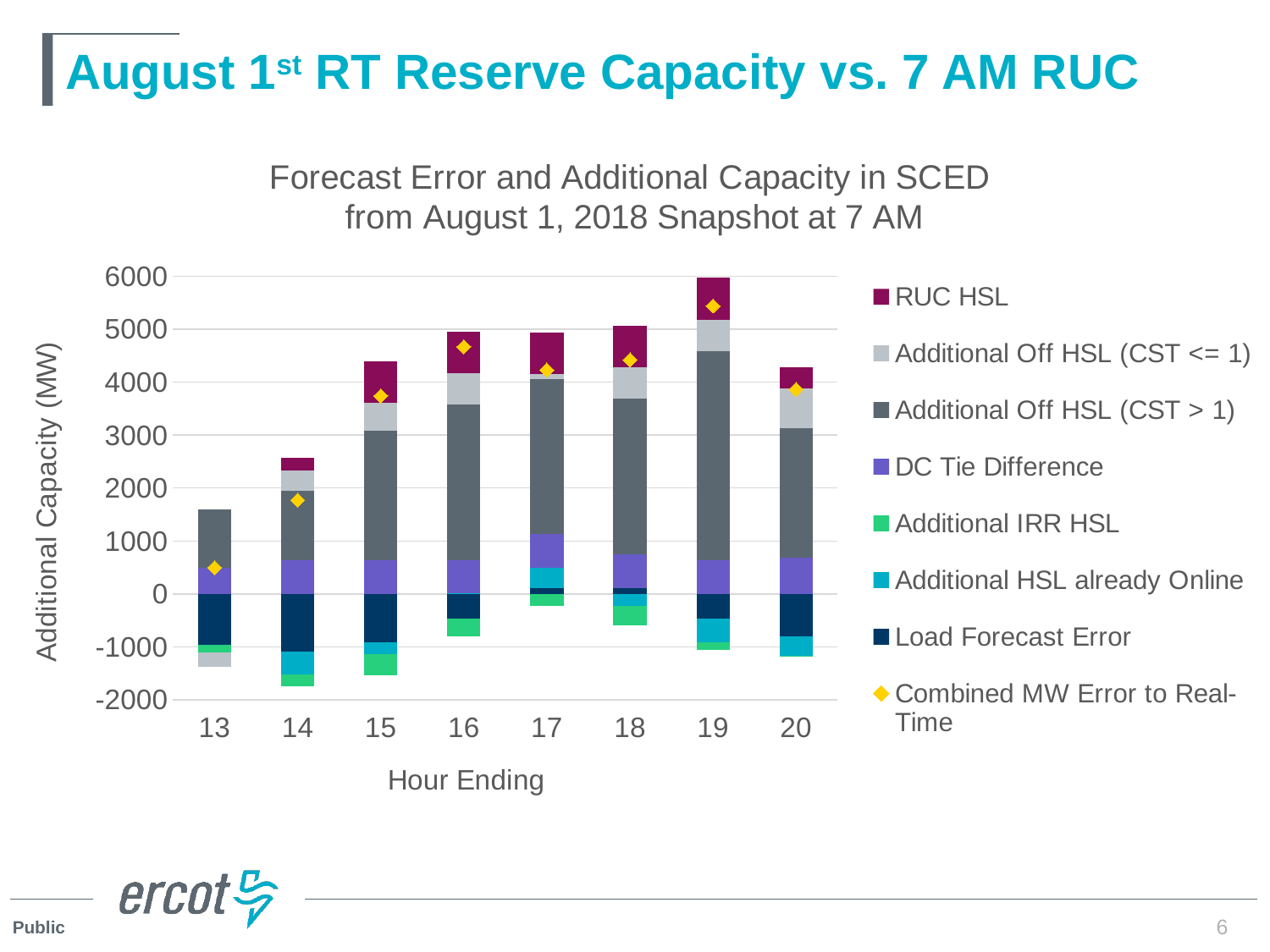
Which hour ending has the Combined MW Error to Real-Time marker higher, 16 or 17? 16 What kind of chart is shown on the slide? bar chart At which hour ending is the Combined MW Error to Real-Time marker highest? 19 Does the Combined MW Error to Real-Time marker rise or fall from hour ending 13 to hour ending 16? rise Is the Combined MW Error to Real-Time value for hour ending 16 greater or less than 4000? greater How many hour-ending categories are shown on the x axis? 8 Is the Combined MW Error to Real-Time value for hour ending 13 greater or less than 1000? less How many series does the legend list? 8 At which hour ending is the Combined MW Error to Real-Time marker lowest? 13 What is the title of the x axis? Hour Ending What is the title of the y axis? Additional Capacity (MW) Is the Combined MW Error to Real-Time value for hour ending 19 greater or less than 5000? greater